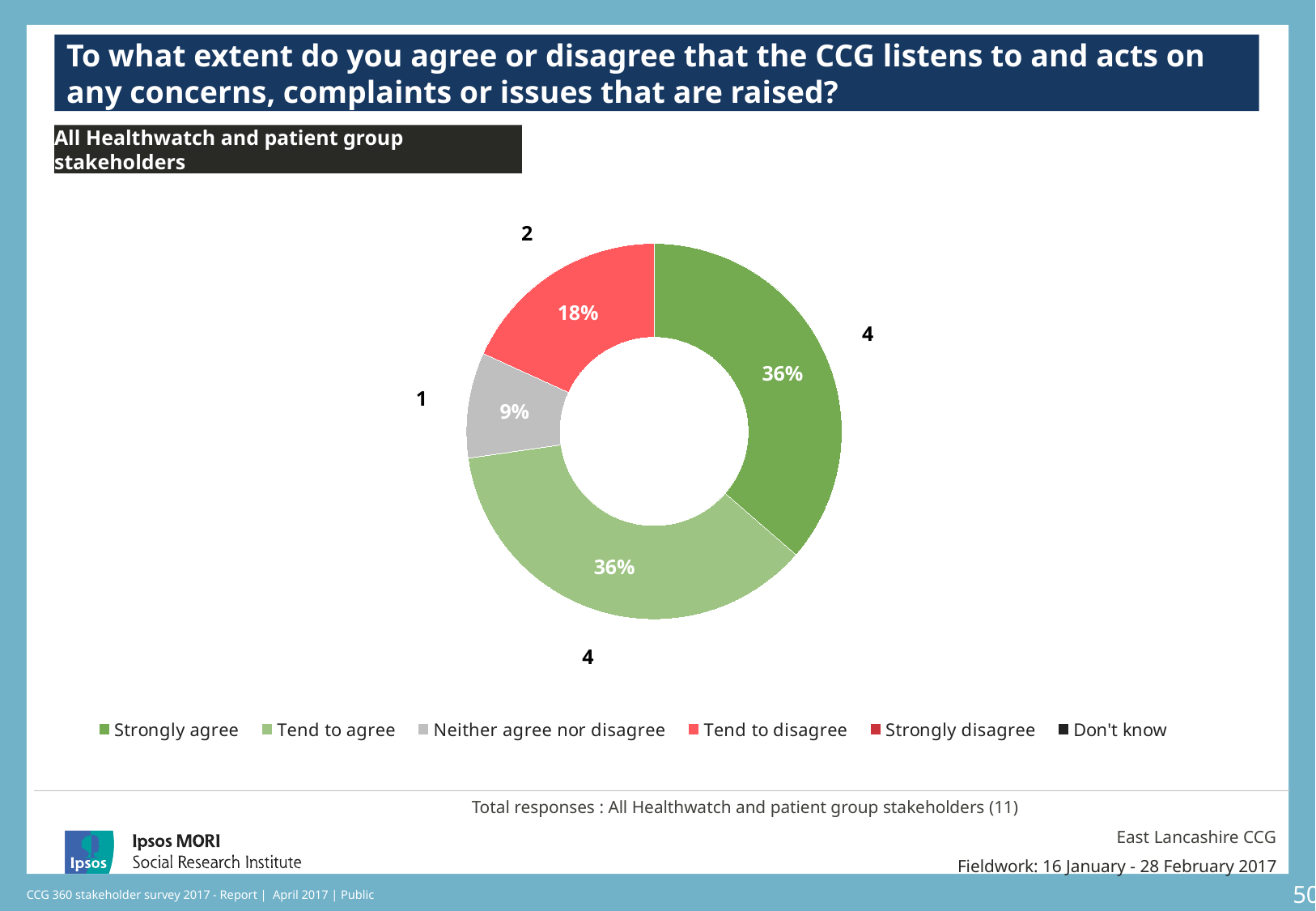
What is the total number of responses stated on the slide? 11 What percentage of respondents said they strongly agree? 36% How many response categories does the legend list? 6 Which is larger: the share for 'Tend to disagree' or the share for 'Neither agree nor disagree'? Tend to disagree What percentage of respondents said they tend to disagree? 18% How many respondents said they tend to agree? 4 What is the difference in percentage points between 'Tend to disagree' and 'Neither agree nor disagree'? 9 What is the combined percentage for 'Strongly agree' and 'Tend to agree'? 72% What type of chart is shown on the slide? Pie (donut) chart How many respondents said they tend to disagree? 2 What percentage of respondents said they neither agree nor disagree? 9% Which response category has the smallest visible slice in the chart? Neither agree nor disagree